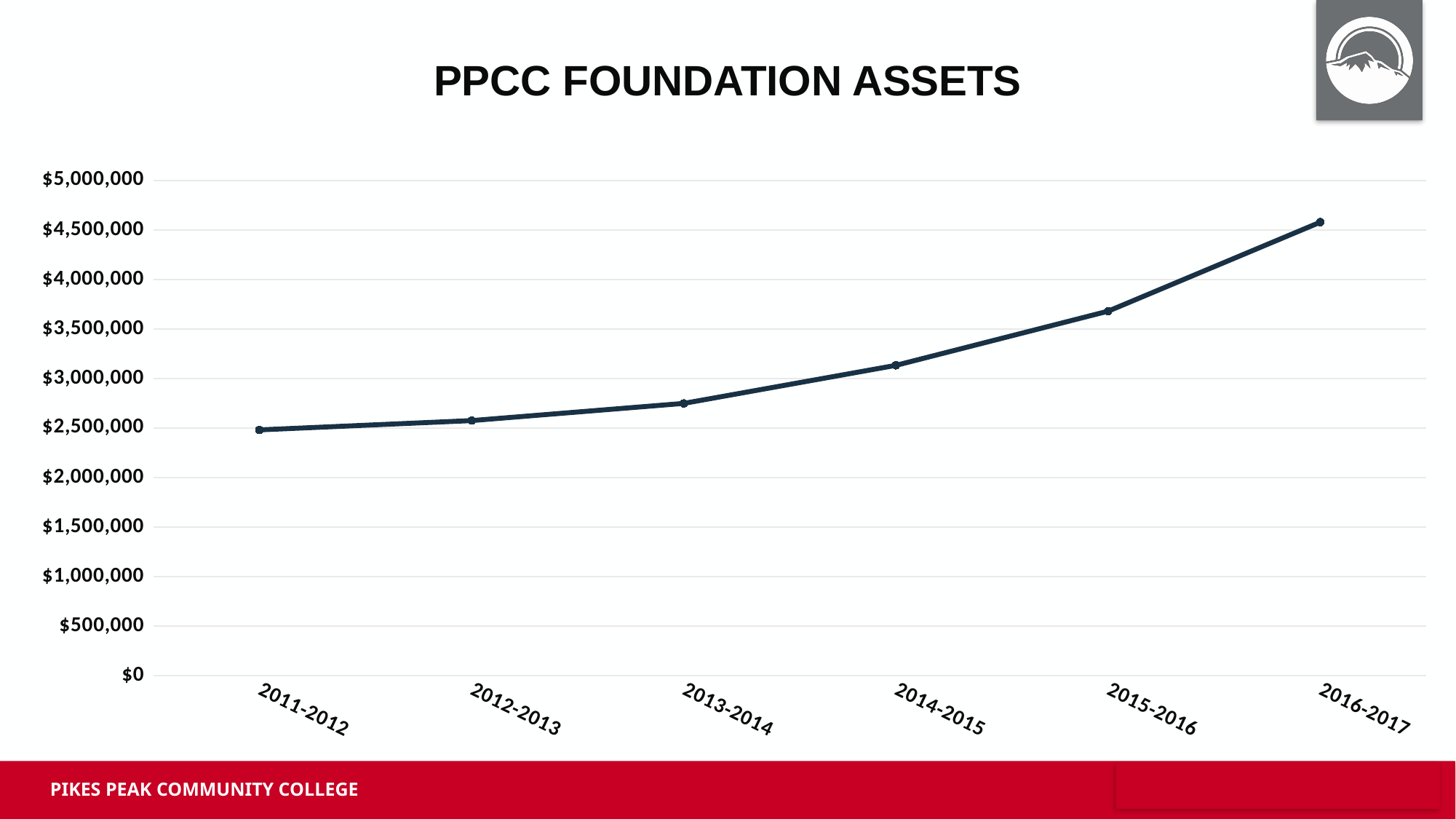
Which year has the lowest foundation assets? 2011-2012 How many data points are plotted on the line? 6 What is the highest value shown on the vertical axis? $5,000,000 Is the value for 2013-2014 greater or less than $3,000,000? less Is the value for 2015-2016 greater or less than $3,500,000? greater Which year has the highest foundation assets? 2016-2017 What kind of chart is shown on the slide? line chart Is the value for 2016-2017 greater or less than $4,000,000? greater What is the title of the chart? PPCC FOUNDATION ASSETS Which year has higher foundation assets, 2013-2014 or 2015-2016? 2015-2016 Do the foundation assets rise or fall from 2011-2012 to 2016-2017? rise